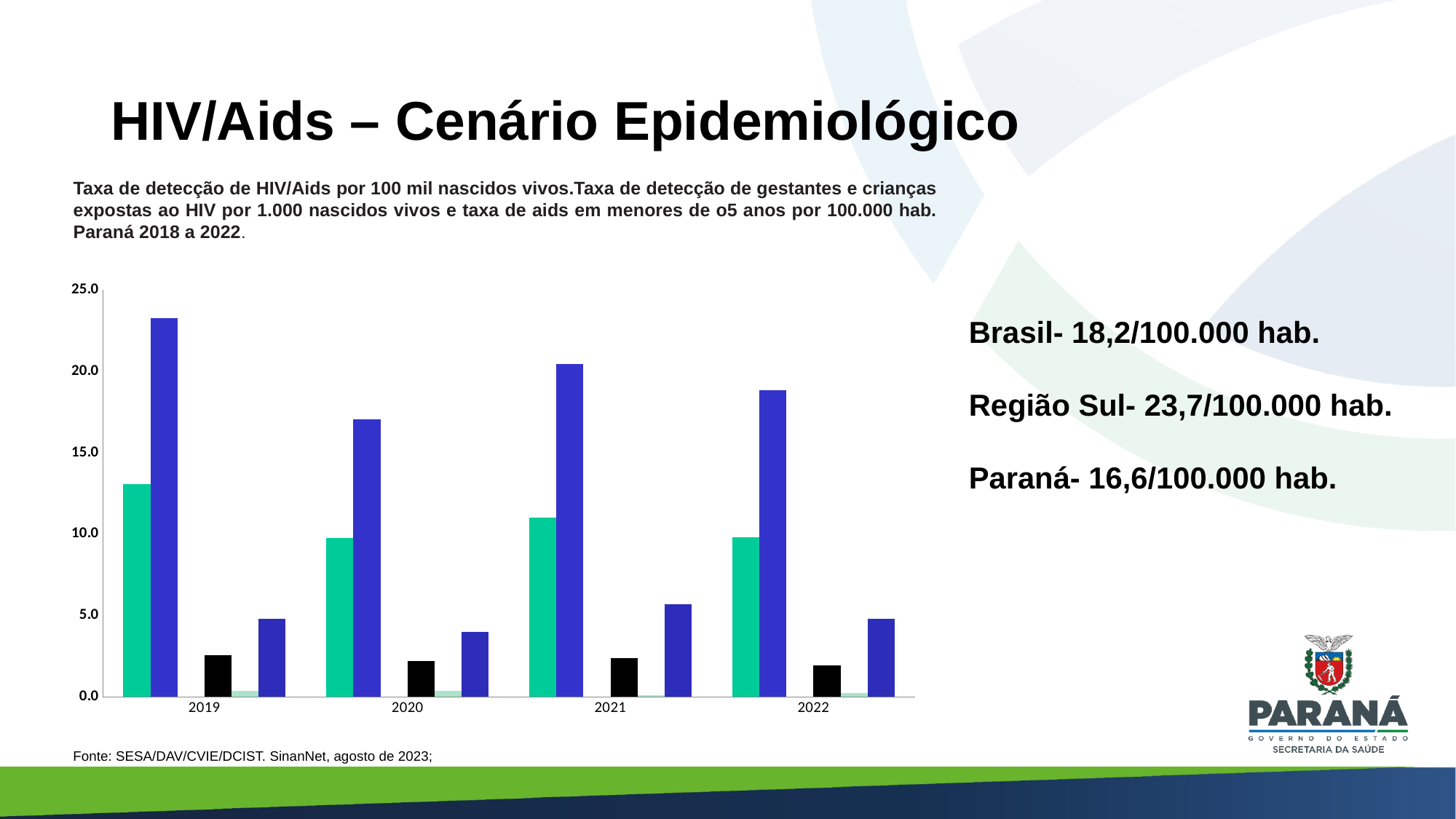
Which is larger in 2019: the teal (first) bar or the dark blue (second) bar? the dark blue bar Is the value of the dark blue (second) bar for 2020 greater or less than 20.0? less In which year is the dark blue (second) bar the shortest? 2020 In which year is the teal (first) bar the tallest? 2019 Is the value of the teal (first) bar for 2019 greater or less than 10.0? greater Which is larger for the dark blue (second) bar: 2021 or 2022? 2021 Is the value of the dark blue (second) bar for 2019 greater or less than 20.0? greater In which year is the dark blue (second) bar the tallest? 2019 In which year is the medium blue (fifth) bar the tallest? 2021 How many years are shown on the x axis of the chart? 4 What kind of chart is shown on the slide? bar chart